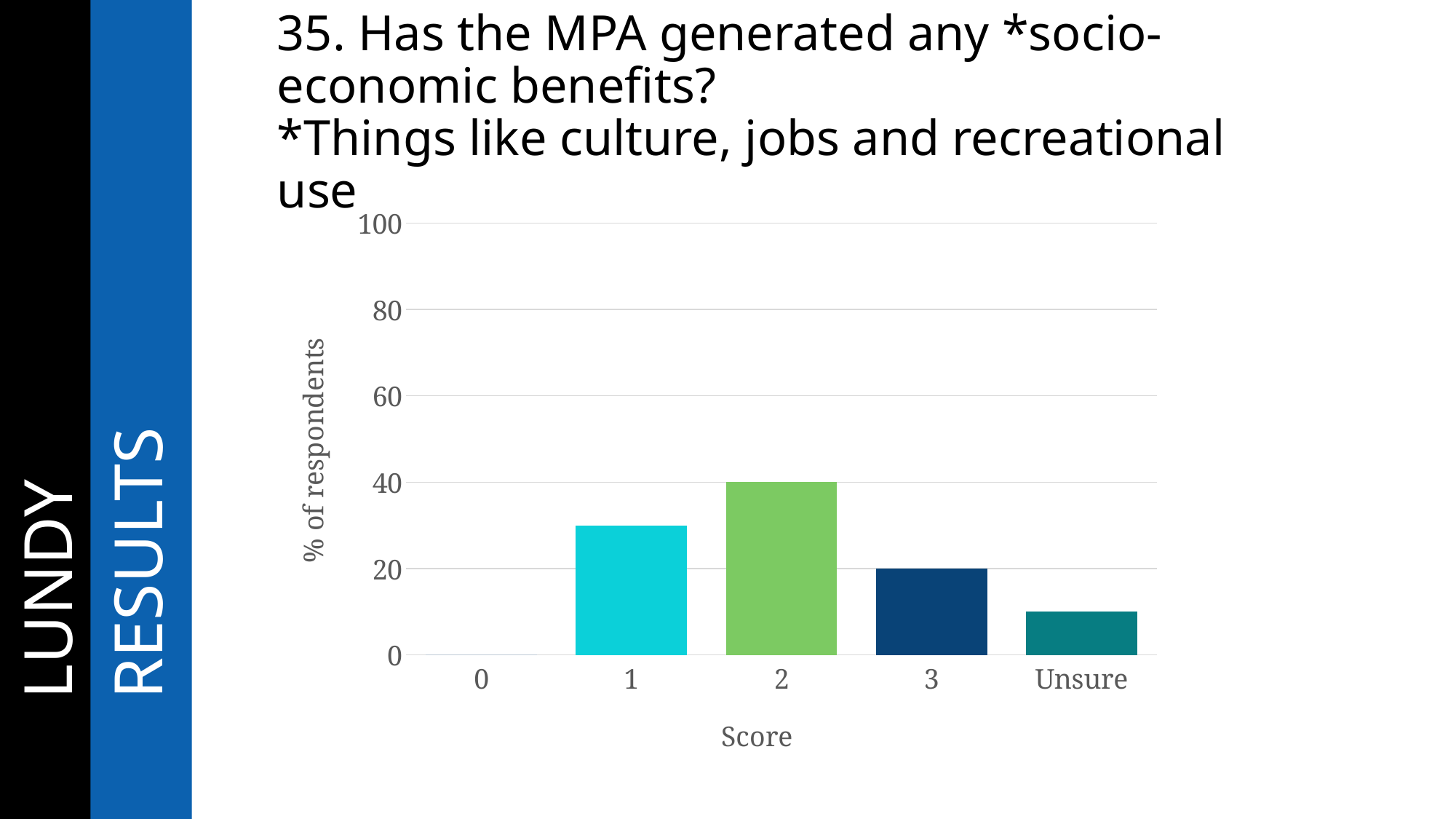
Which score category has the lowest percentage of respondents? 0 What is the difference in percentage of respondents between score 2 and score 3? 20 What percentage of respondents gave a score of 0? 0 What percentage of respondents gave a score of 3? 20 Is the value for score 1 greater or less than 20? greater How many score categories are shown on the x axis? 5 What percentage of respondents gave a score of 2? 40 Which score category has the highest percentage of respondents? 2 What is the label on the y axis of the chart? % of respondents Is the value for Unsure greater or less than 20? less Which has a higher percentage of respondents, score 1 or score 3? 1 What kind of chart is shown on the slide? bar chart